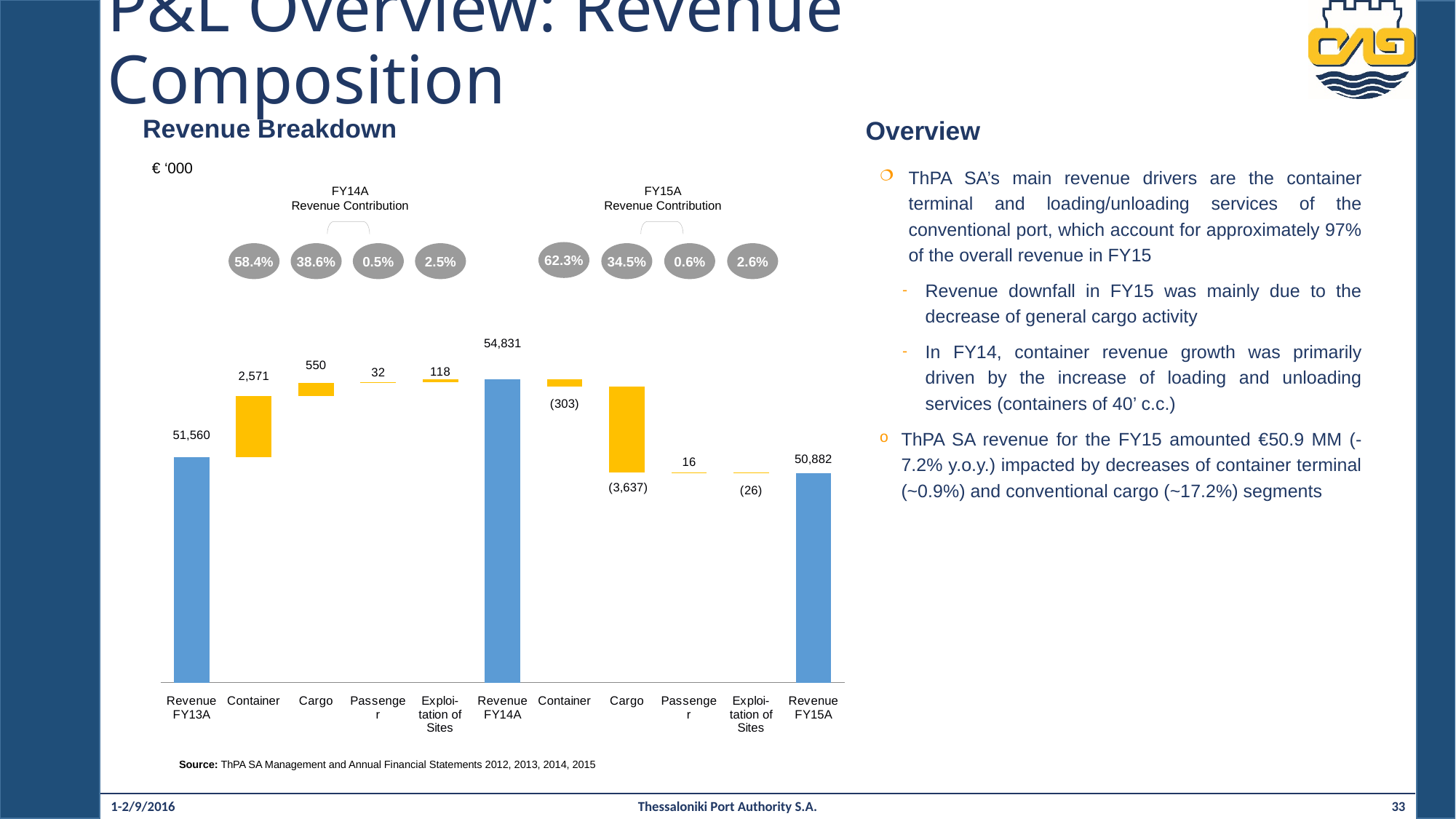
What is the value shown for the Container change between Revenue FY13A and Revenue FY14A? 2,571 Which of the three total revenue bars (FY13A, FY14A, FY15A) is the highest? Revenue FY14A Which is larger, the Revenue FY13A value or the Revenue FY15A value? Revenue FY13A What is the value of the Revenue FY14A bar in the Revenue Breakdown chart? 54,831 What is the value shown for the Cargo change between Revenue FY14A and Revenue FY15A? (3,637) What is the value of the Revenue FY13A bar in the Revenue Breakdown chart? 51,560 What percentage is shown for the container contribution to FY15A revenue? 62.3% What is the value of the Revenue FY15A bar in the Revenue Breakdown chart? 50,882 How many bars are plotted along the x axis of the Revenue Breakdown chart? 11 What is the difference between the Revenue FY14A and Revenue FY13A values? 3,271 What is the value shown for the Exploitation of Sites change between Revenue FY13A and Revenue FY14A? 118 What is the difference between the Revenue FY14A and Revenue FY15A values? 3,949